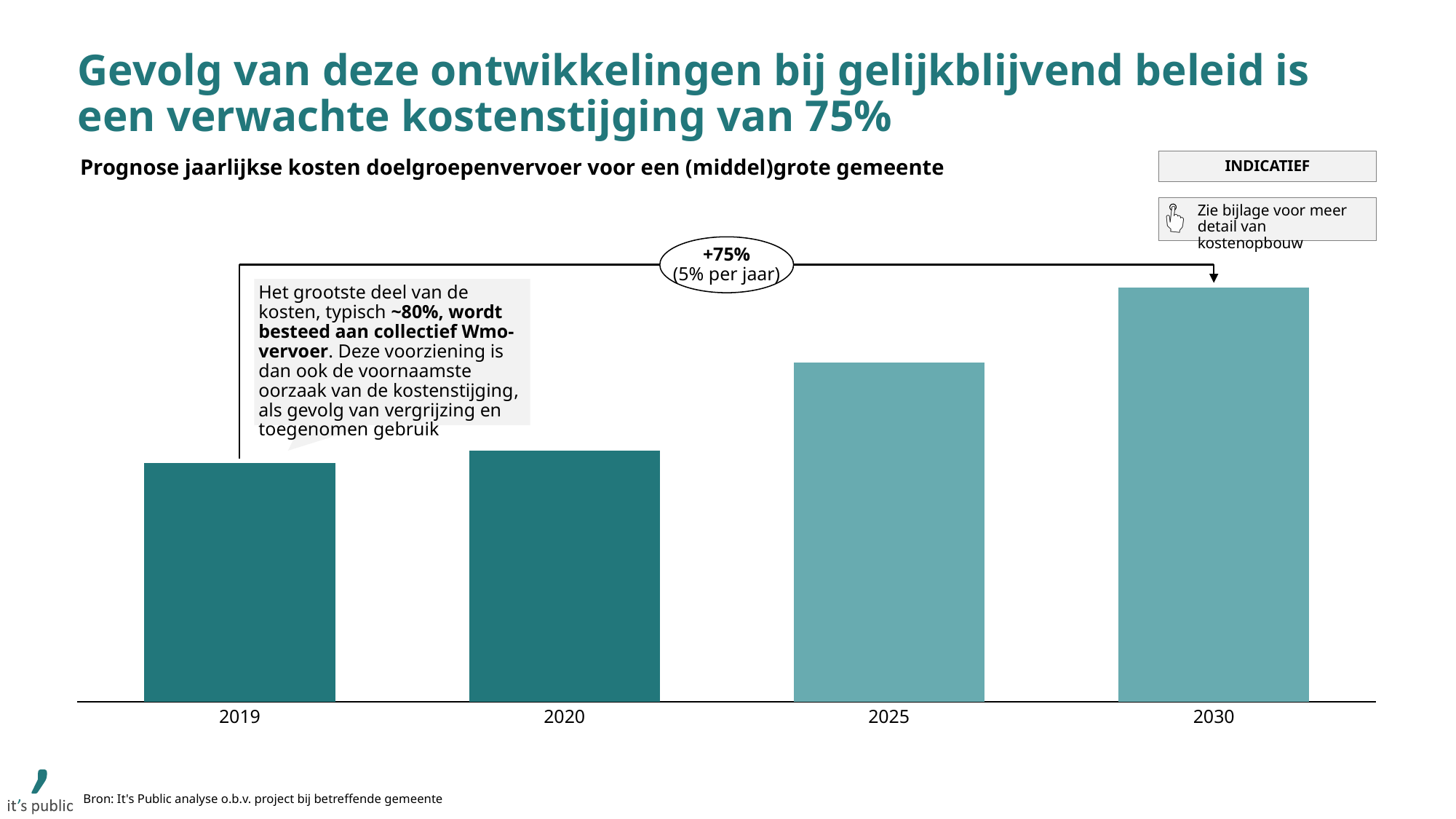
What is the title of the chart? Prognose jaarlijkse kosten doelgroepenvervoer voor een (middel)grote gemeente What kind of chart is shown on the slide? bar chart Which year is the first category on the x axis? 2019 What percentage increase does the annotation arrow from 2019 to 2030 indicate? +75% Which bar is taller, 2020 or 2025? 2025 Which year has the lowest bar in the chart? 2019 How many years (bars) are shown on the x axis of the chart? 4 Which year has the highest bar in the chart? 2030 Which bar is taller, 2019 or 2030? 2030 Do the bar values rise or fall from 2019 to 2030? rise Which year is the last category on the x axis? 2030